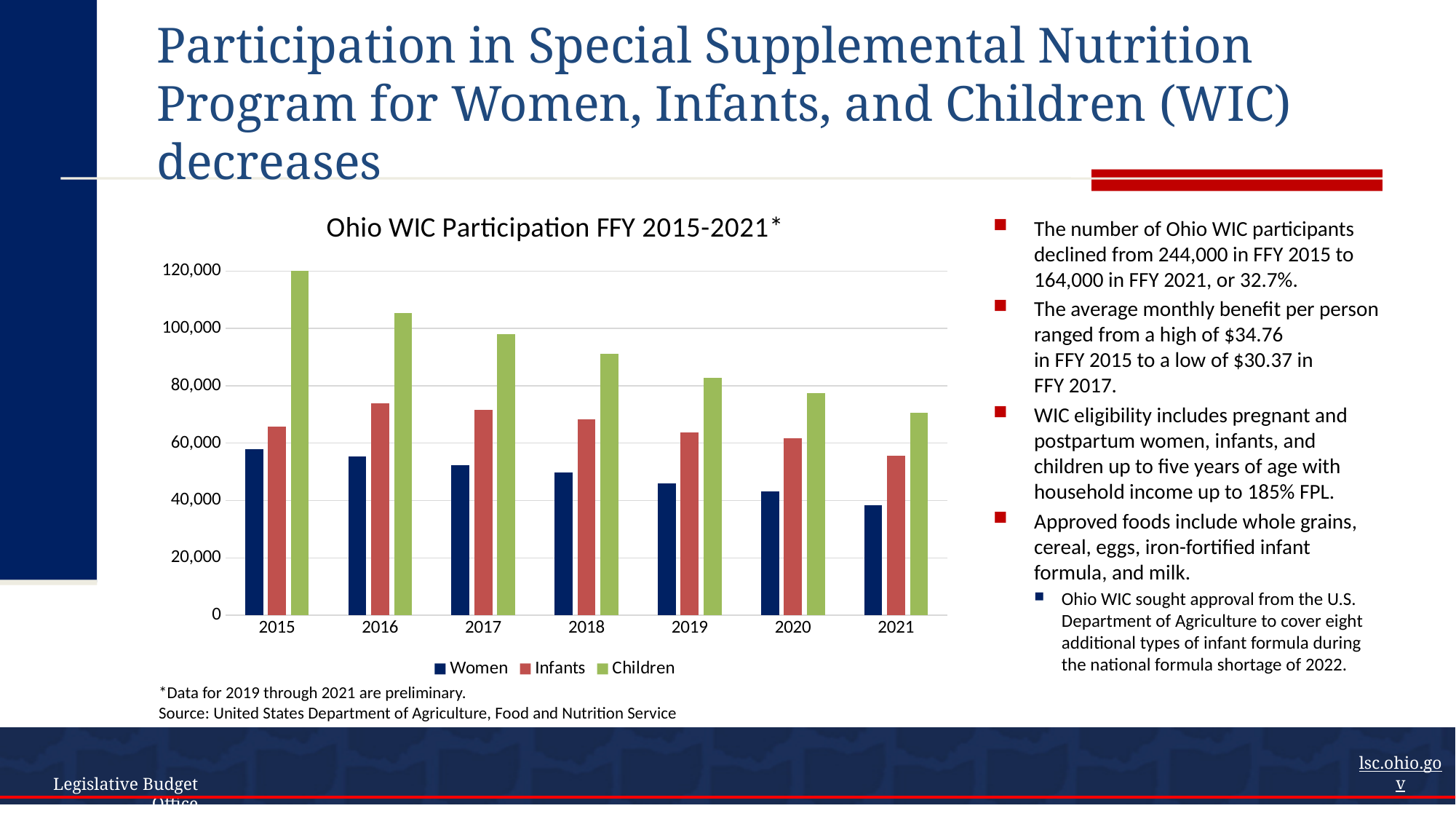
What kind of chart is shown on the slide? Bar chart Do the values for Women rise or fall from 2015 to 2021? Fall Which series is represented by the green bars in the chart? Children In 2016, which is larger: the value for Infants or the value for Women? Infants Is the value for Infants in 2021 greater or less than 60,000? less In which year is the Children series highest? 2015 How many years are shown on the x axis of the chart? 7 What is the title of the chart? Ohio WIC Participation FFY 2015-2021* In which year is the Women series lowest? 2021 Is the value for Women in 2021 greater or less than 40,000? less How many series does the legend of the chart list? 3 Is the value for Children in 2015 greater or less than 100,000? greater